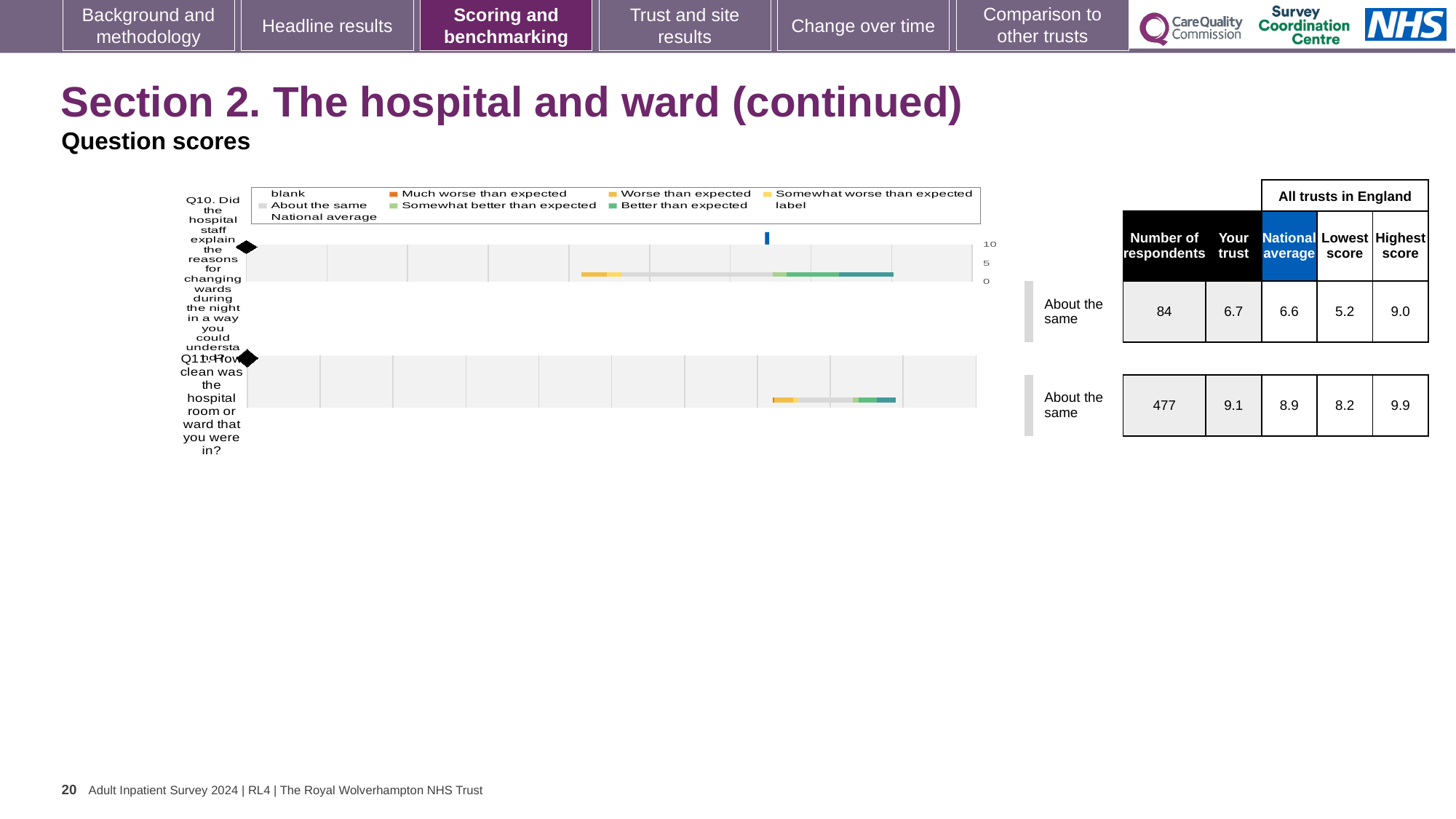
What is the national average score for Q10? 6.6 What is the difference between the highest score and the lowest score for Q11? 1.7 What is the difference between the highest score and the lowest score for Q10? 3.8 According to the table, what is the 'Your trust' score for Q11? 9.1 According to the table, what is the 'Your trust' score for Q10? 6.7 How many respondents answered Q11? 477 Which legend category is shown in grey on the chart? About the same What kind of chart is used to show the Q10 and Q11 question scores? bar chart What is the highest tick value shown on the chart's score axis? 10 What benchmark category is given for Q11? About the same For Q11, which is larger: the 'Your trust' score or the national average? Your trust How many survey questions are plotted on the chart? 2